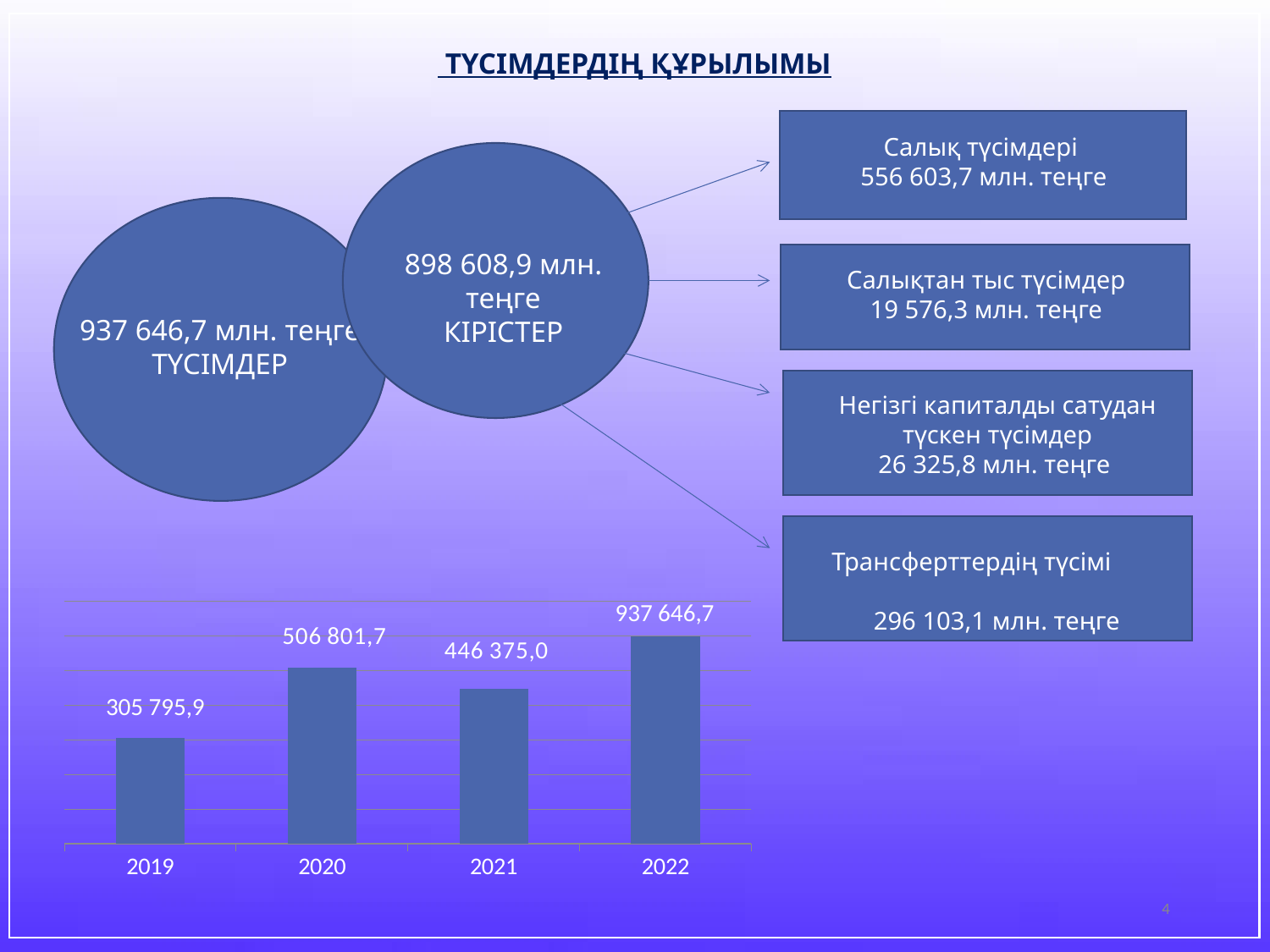
In the bar chart, which is larger: the value for 2020 or the value for 2021? 2020 What is the value shown for 2022 in the bar chart? 937 646,7 What type of chart is shown at the bottom of the slide? Bar chart What is the value shown for 2020 in the bar chart? 506 801,7 What is the difference between the 2020 and 2021 values in the bar chart? 60 426,7 What is the value shown for 2021 in the bar chart? 446 375,0 What is the difference between the 2022 and 2019 values in the bar chart? 631 850,8 Which year has the lowest value in the bar chart? 2019 Does the value in the bar chart rise or fall from 2020 to 2021? Fall How many years are shown in the bar chart? 4 What is the value shown for 2019 in the bar chart? 305 795,9 Which year has the highest value in the bar chart? 2022